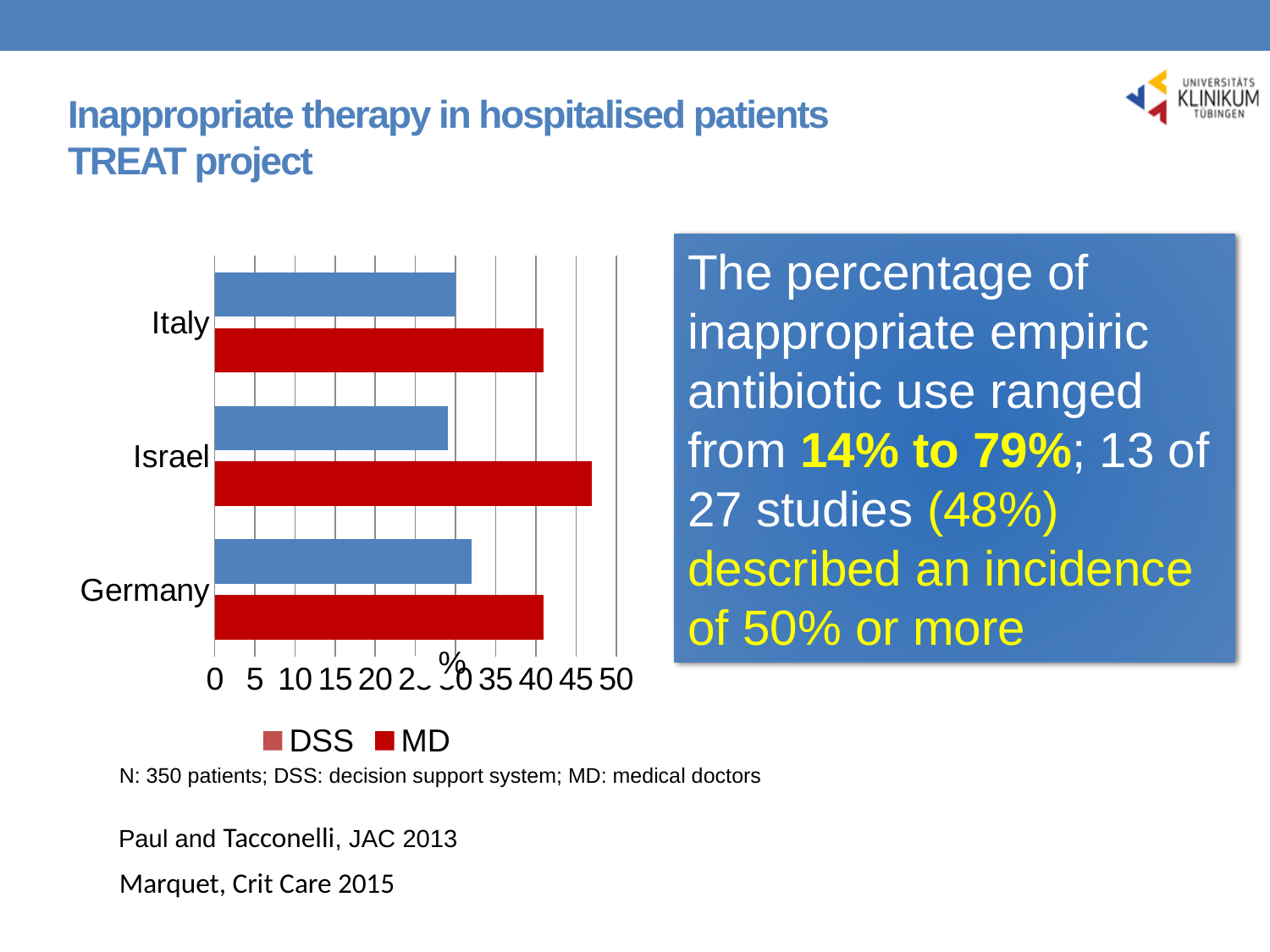
Which country has the highest MD value? Israel What unit is shown on the horizontal axis of the chart? % How many countries are shown on the chart? 3 Is the MD value for Israel greater or less than 40? greater What kind of chart is shown on the slide? bar chart How many series does the chart legend list? 2 For Italy, which is larger, the DSS value or the MD value? MD What are the two series named in the chart legend? DSS and MD For Israel, which is larger, the DSS value or the MD value? MD Is the DSS value for Germany greater or less than 35? less Is the MD value for Italy greater or less than 35? greater For Germany, which is larger, the DSS value or the MD value? MD